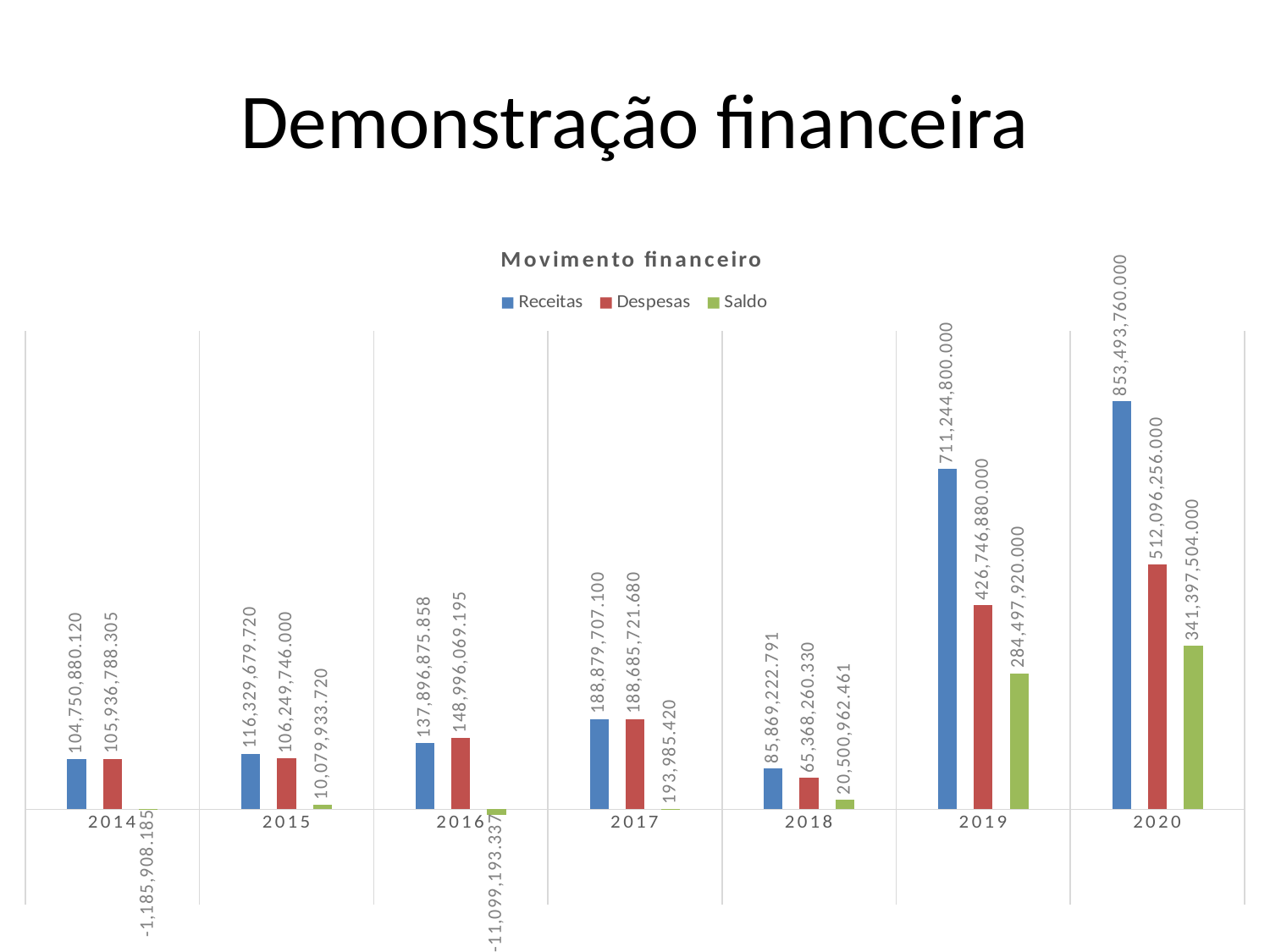
What is the Saldo value for 2016? -11,099,193.337 What is the value of Receitas for 2020? 853,493,760.000 What is the difference between Receitas and Despesas in 2019? 284,497,920.000 What is the value of Despesas for 2019? 426,746,880.000 In 2016, which is larger, Receitas or Despesas? Despesas Which year has the highest Receitas value? 2020 How many series does the legend list? 3 Which year has the lowest Saldo value? 2016 Which year has the lowest Receitas value? 2018 What is the value of Receitas for 2018? 85,869,222.791 What kind of chart is shown on the slide? Bar chart How many years are shown on the x axis? 7